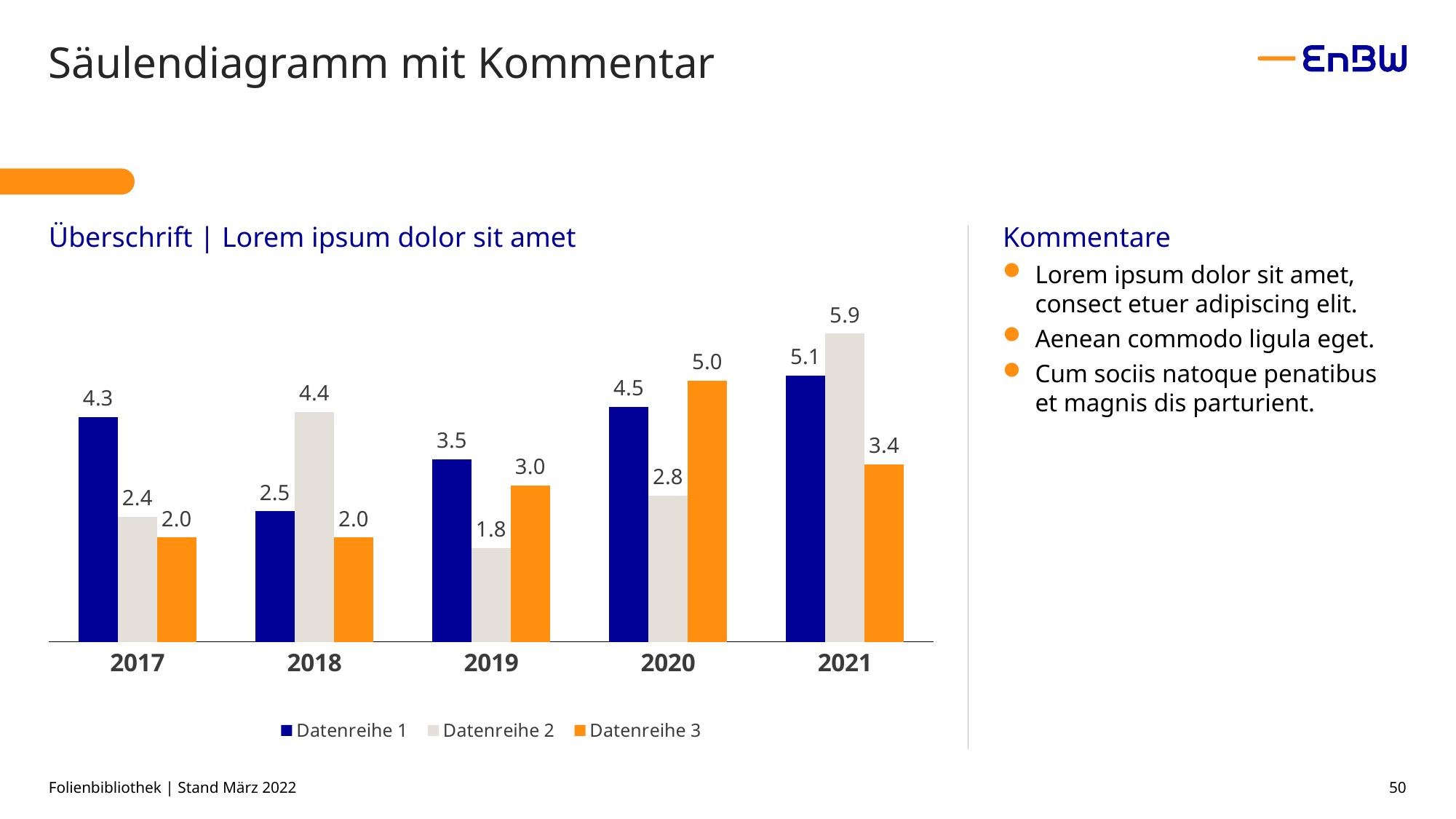
Does Datenreihe 1 rise or fall from 2018 to 2021? Rise In which year is Datenreihe 2 highest? 2021 What is the value for Datenreihe 1 in 2017? 4.3 Which is larger in 2018: Datenreihe 1 or Datenreihe 2? Datenreihe 2 What colour are the bars for Datenreihe 3? Orange In which year is Datenreihe 1 lowest? 2018 How many series does the legend list? 3 What is the difference between Datenreihe 2 and Datenreihe 3 in 2021? 2.5 How many years are shown on the x axis? 5 What kind of chart is shown on the slide? Bar chart What is the value for Datenreihe 3 in 2020? 5.0 What is the value for Datenreihe 2 in 2019? 1.8